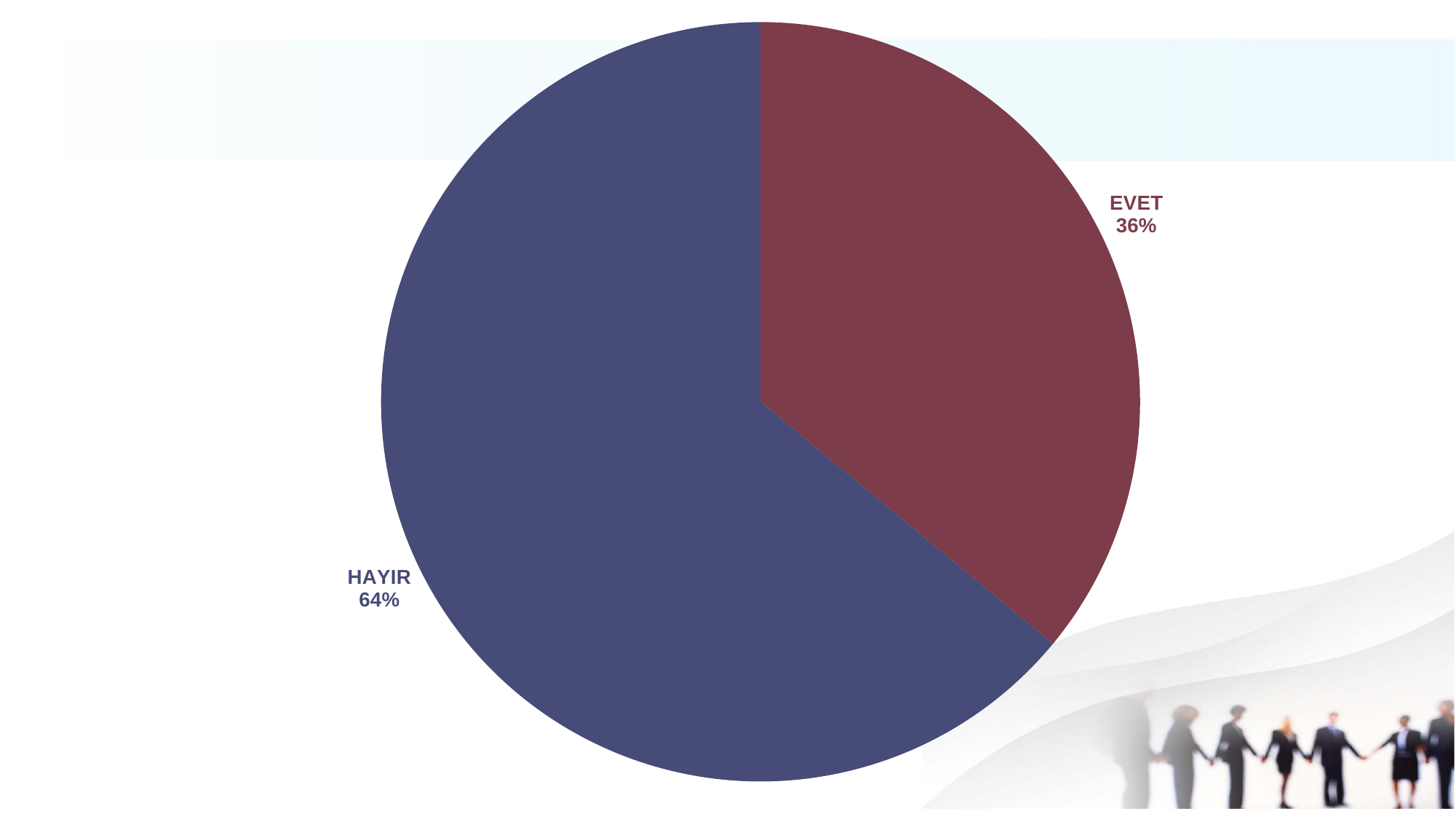
What colour is the EVET slice? dark red What kind of chart is shown on the slide? pie chart What is the difference in percentage points between the HAYIR and EVET slices? 28% What colour is the HAYIR slice? dark blue What share of the pie does the EVET slice represent? 36% What share of the pie does the HAYIR slice represent? 64% Which is larger, the EVET slice or the HAYIR slice? HAYIR How many slices does the pie chart have? 2 Which slice is the largest? HAYIR Which slice is the smallest? EVET